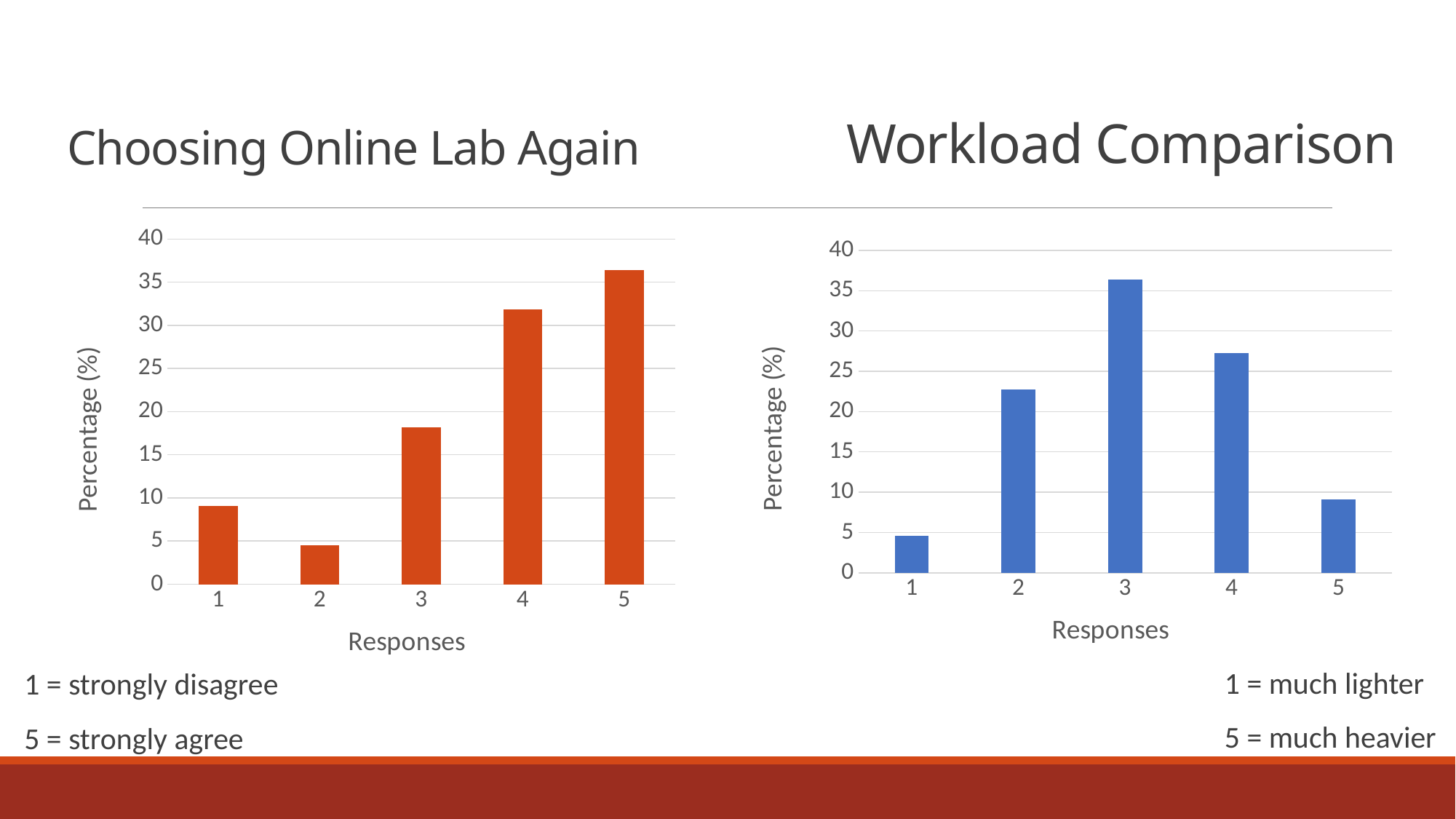
What is the y-axis label on the "Workload Comparison" chart? Percentage (%) In the "Choosing Online Lab Again" chart, is the value for response 3 greater or less than 20? less In the "Workload Comparison" chart, which response has the highest percentage? 3 What kind of chart is the "Choosing Online Lab Again" chart? bar chart In the "Choosing Online Lab Again" chart, which response has the lowest percentage? 2 In the "Workload Comparison" chart, which is larger, the value for response 4 or the value for response 5? response 4 How many response categories are shown on the x axis of the "Choosing Online Lab Again" chart? 5 In the "Choosing Online Lab Again" chart, do the values rise or fall from response 2 to response 5? rise In the "Workload Comparison" chart, which response has the lowest percentage? 1 In the "Choosing Online Lab Again" chart, is the value for response 4 greater or less than 30? greater In the "Choosing Online Lab Again" chart, which response has the highest percentage? 5 In the "Workload Comparison" chart, is the value for response 2 greater or less than 20? greater